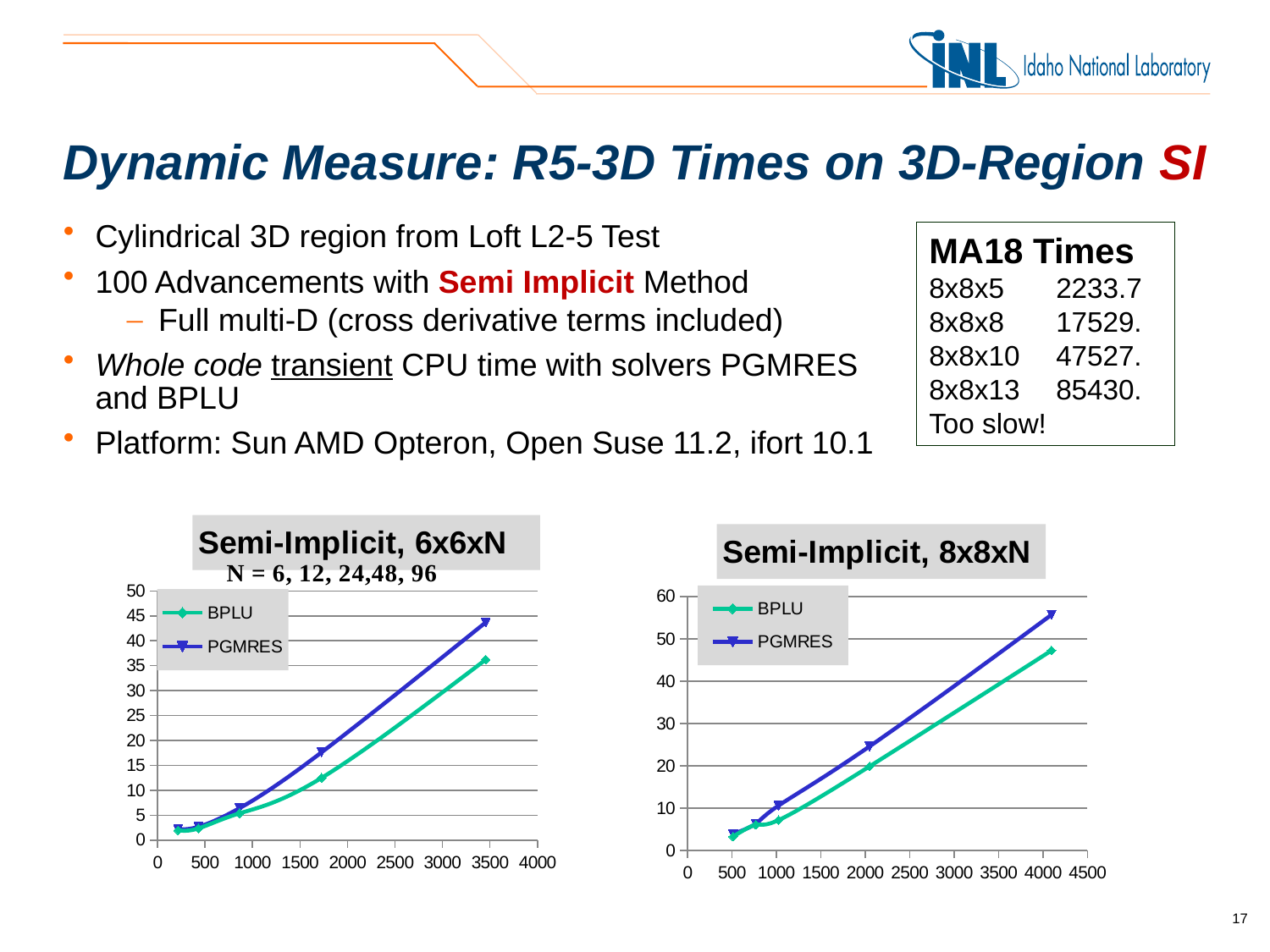
In the 'Semi-Implicit, 8x8xN' chart, how many data points does the BPLU series have? 5 What are the two series named in the legend of the 'Semi-Implicit, 6x6xN' chart? BPLU and PGMRES In the 'Semi-Implicit, 8x8xN' chart, which series is higher at the rightmost data point, BPLU or PGMRES? PGMRES In the 'Semi-Implicit, 6x6xN' chart, is the rightmost BPLU value greater or less than 40? less What kind of chart is the 'Semi-Implicit, 6x6xN' chart? line chart In the 'Semi-Implicit, 8x8xN' chart, is the rightmost PGMRES value greater or less than 50? greater In the 'Semi-Implicit, 8x8xN' chart, is the rightmost BPLU value greater or less than 50? less What is the title of the chart on the right side of the slide? Semi-Implicit, 8x8xN In the 'Semi-Implicit, 6x6xN' chart, do the BPLU values rise or fall as the x-axis value increases? rise How many series does the legend of the 'Semi-Implicit, 8x8xN' chart list? 2 In the 'Semi-Implicit, 6x6xN' chart, how many data points does the PGMRES series have? 5